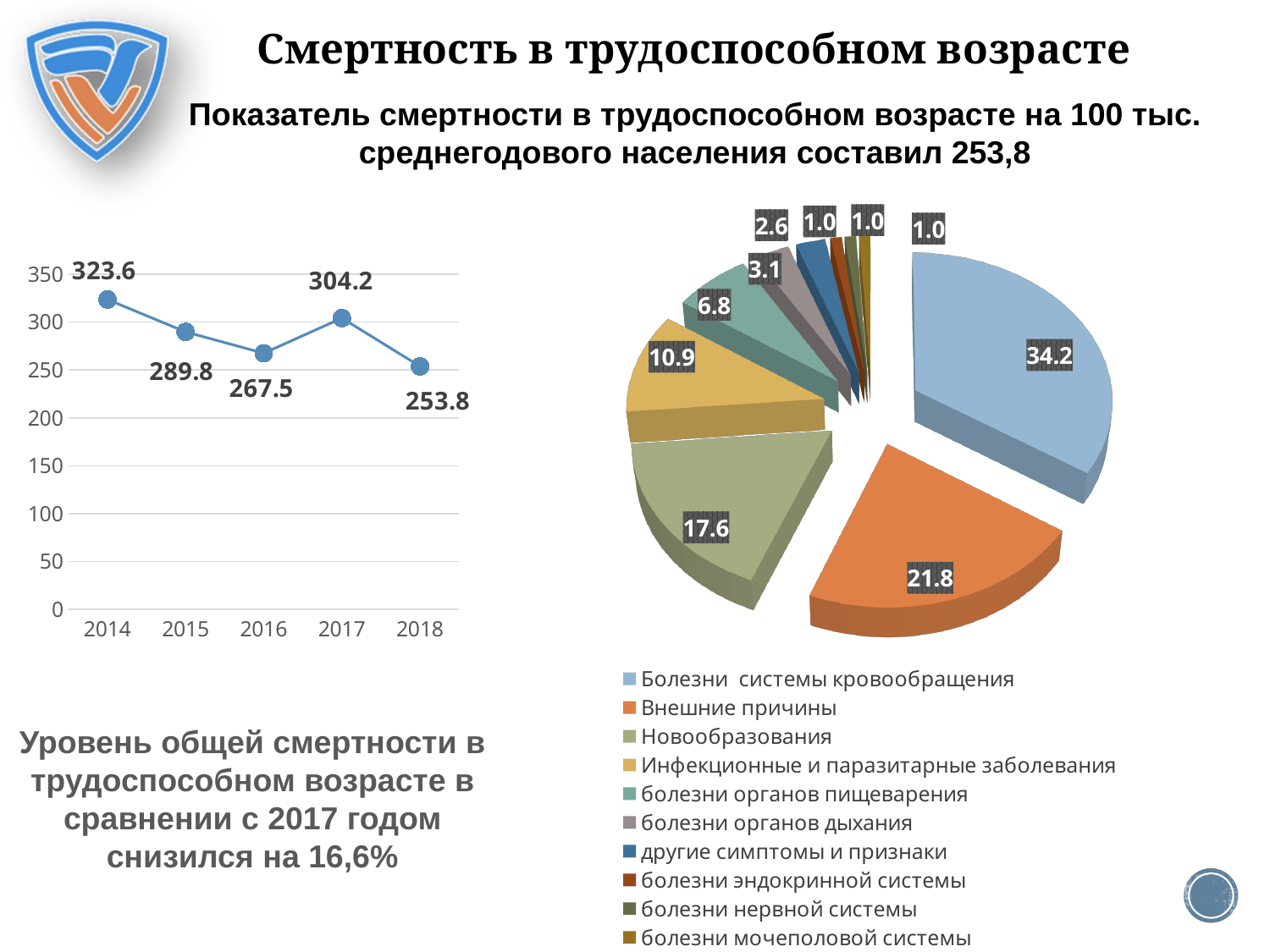
On the line chart on the left, what is the value for 2014? 323.6 On the line chart on the left, which year has the lowest value? 2018 On the line chart on the left, what is the value for 2018? 253.8 On the line chart on the left, is the value for 2016 larger or smaller than the value for 2017? smaller How many entries does the legend of the pie chart on the right list? 10 On the line chart on the left, how many years are plotted? 5 What type of chart is shown on the left of the slide? line chart On the line chart on the left, what is the difference between the values for 2017 and 2018? 50.4 On the pie chart on the right, what is the difference between the values for Новообразования and Инфекционные и паразитарные заболевания? 6.7 On the pie chart on the right, what is the value for Внешние причины? 21.8 On the line chart on the left, which year has the highest value? 2014 On the pie chart on the right, which category has the largest slice? Болезни системы кровообращения